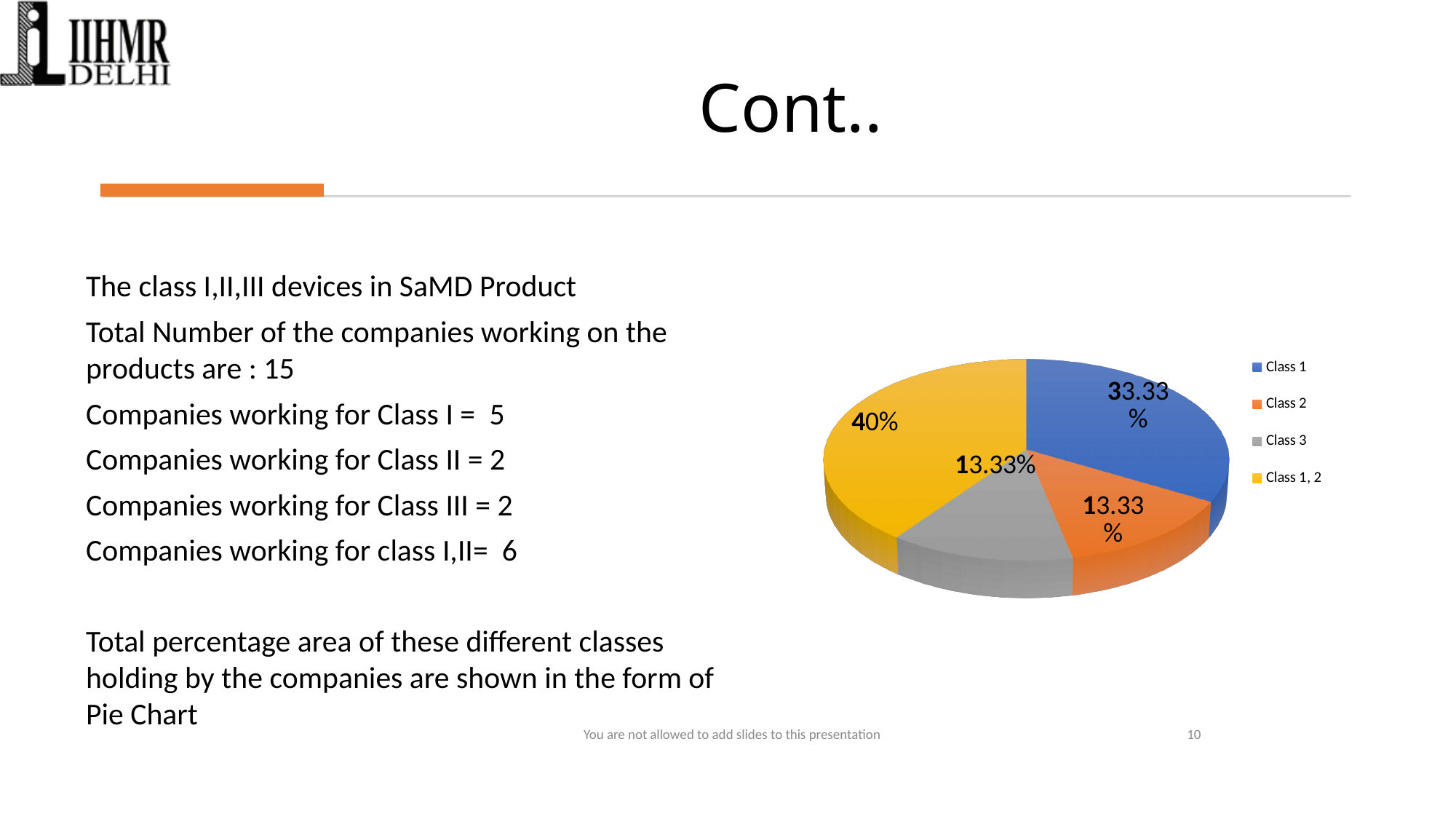
How many entries does the legend of the pie chart list? 4 What kind of chart is shown on the slide? Pie chart What is the difference in percentage points between the Class 1, 2 slice and the Class 1 slice? 6.67 What colour is the Class 3 slice in the pie chart? Grey What percentage of the pie chart is Class 1? 33.33% How many slices does the pie chart have? 4 What percentage of the pie chart is Class 3? 13.33% Which slice of the pie chart is the largest? Class 1, 2 Which is larger in the pie chart, Class 1 or Class 1, 2? Class 1, 2 What percentage of the pie chart is Class 2? 13.33% What percentage of the pie chart is Class 1, 2? 40% Which is larger in the pie chart, Class 1 or Class 3? Class 1